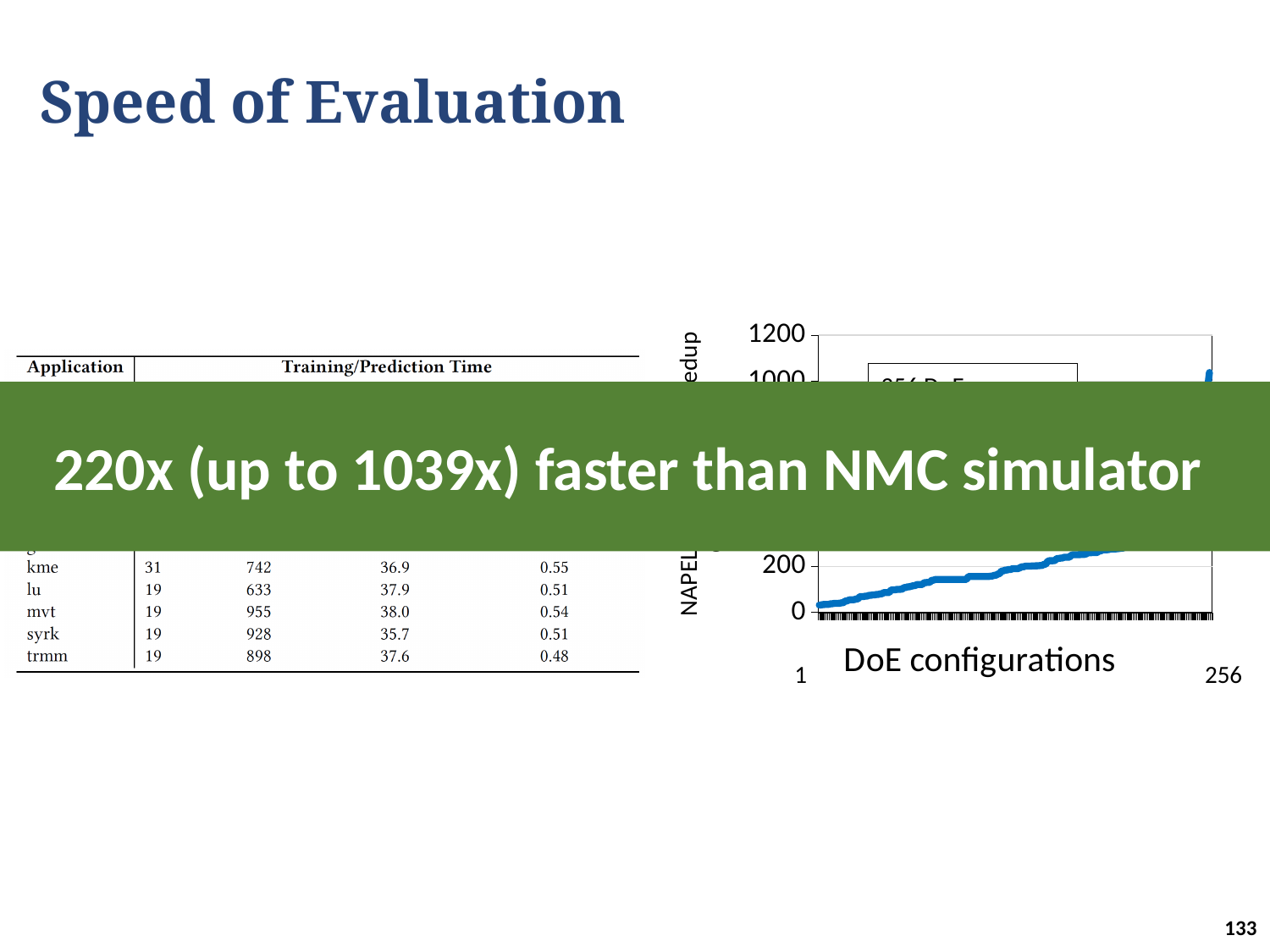
How many DoE configurations does the x axis of the chart on the right span, according to its end labels? 256 What kind of chart is shown on the right of the slide? line chart In the chart on the right, do the values rise or fall as you move from configuration 1 to configuration 256 along the x axis? rise How many lines are plotted in the chart on the right? 1 In the chart on the right, is the value at the first DoE configuration (1) greater or less than 200? less What is the x-axis title of the chart on the right? DoE configurations In the chart on the right, is the value at the last DoE configuration (256) greater or less than 200? greater What is the highest tick value shown on the y axis of the chart on the right? 1200